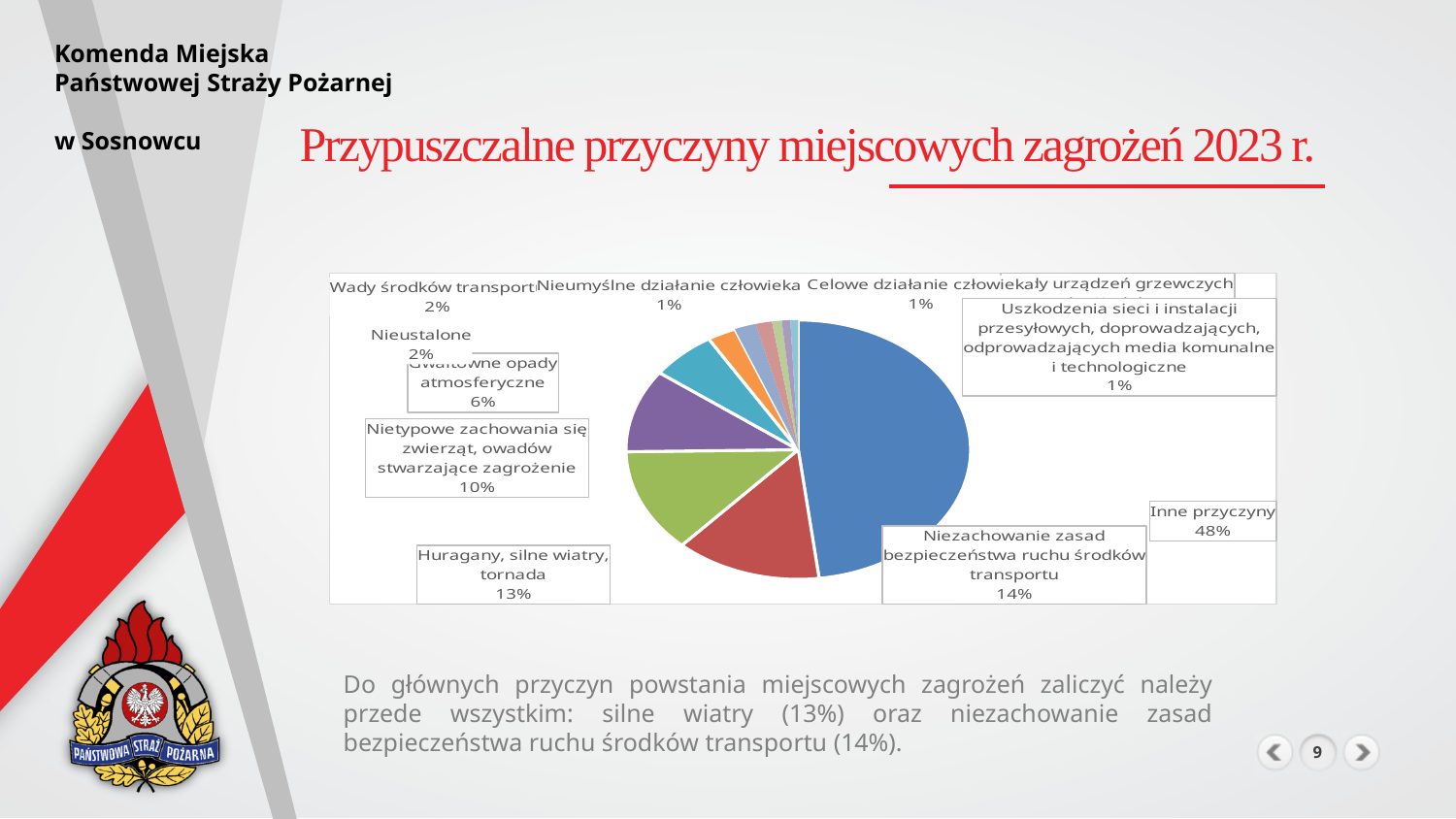
What is the value for "Niezachowanie zasad bezpieczeństwa ruchu środków transportu"? 14% What is the value for "Nietypowe zachowania się zwierząt, owadów stwarzające zagrożenie"? 10% How many slices does the pie chart have? 11 Which category has the largest share of the pie? Inne przyczyny What is the value for "Huragany, silne wiatry, tornada"? 13% What is the difference between "Inne przyczyny" and "Niezachowanie zasad bezpieczeństwa ruchu środków transportu"? 34 percentage points Which is larger: "Huragany, silne wiatry, tornada" or "Nietypowe zachowania się zwierząt, owadów stwarzające zagrożenie"? Huragany, silne wiatry, tornada What kind of chart is shown on the slide? pie chart What is the value for "Nieustalone"? 2% What share of the pie does "Inne przyczyny" have? 48% What is the title of the chart on the slide? Przypuszczalne przyczyny miejscowych zagrożeń 2023 r. What is the value for "Gwałtowne opady atmosferyczne"? 6%